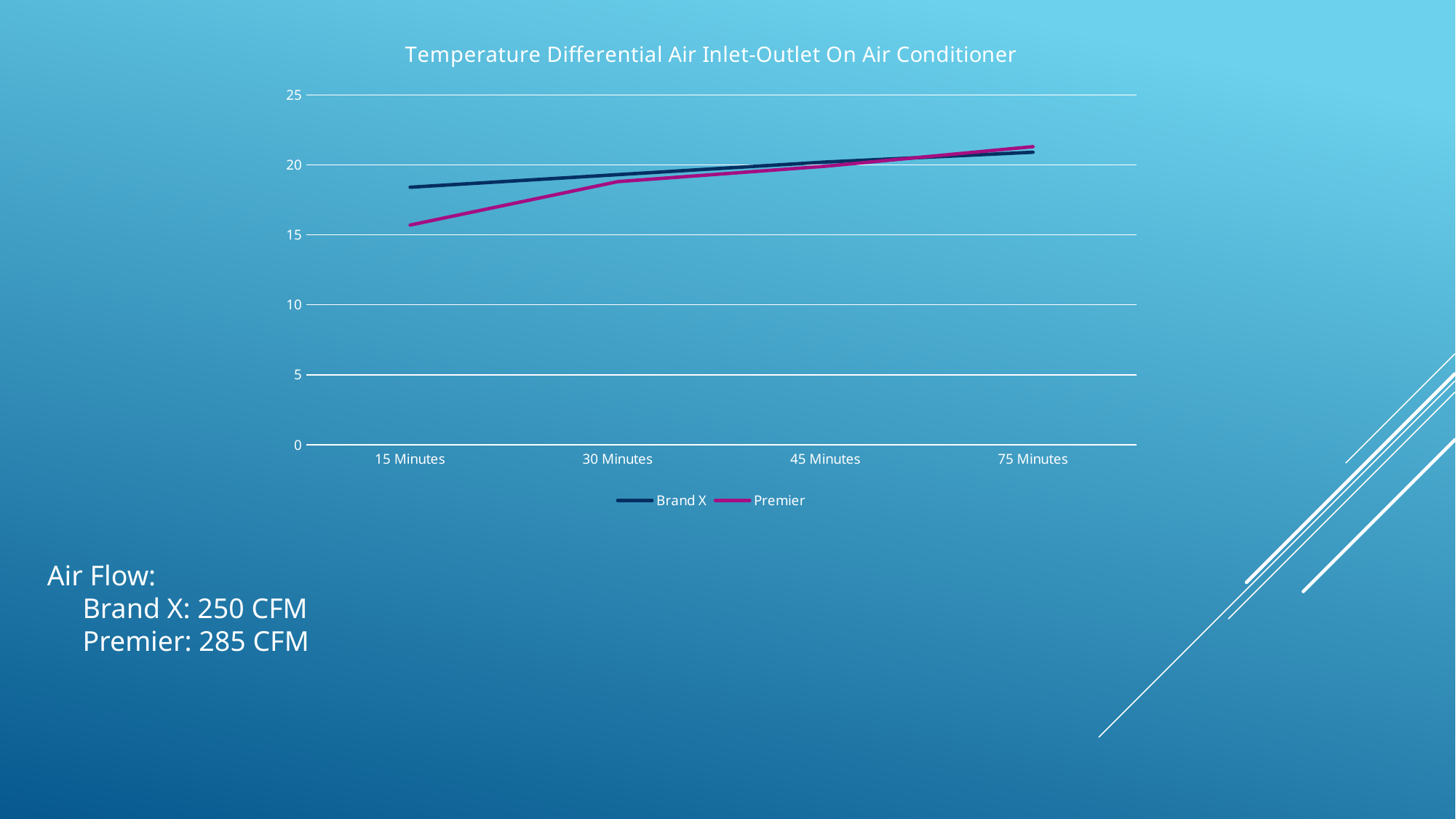
What is the title of the chart? Temperature Differential Air Inlet-Outlet On Air Conditioner What kind of chart is shown on the slide? line chart At which time point is the Premier series at its lowest? 15 Minutes Do the values for Premier rise or fall from 15 Minutes to 75 Minutes? rise Is the value for Brand X at 15 Minutes greater or less than 15? greater How many time points are plotted along the x axis? 4 How many series does the legend list? 2 Which series is drawn in the magenta line? Premier Is the value for Premier at 30 Minutes greater or less than 20? less At 15 Minutes, which series has the higher value, Brand X or Premier? Brand X Is the value for Premier at 75 Minutes greater or less than 20? greater